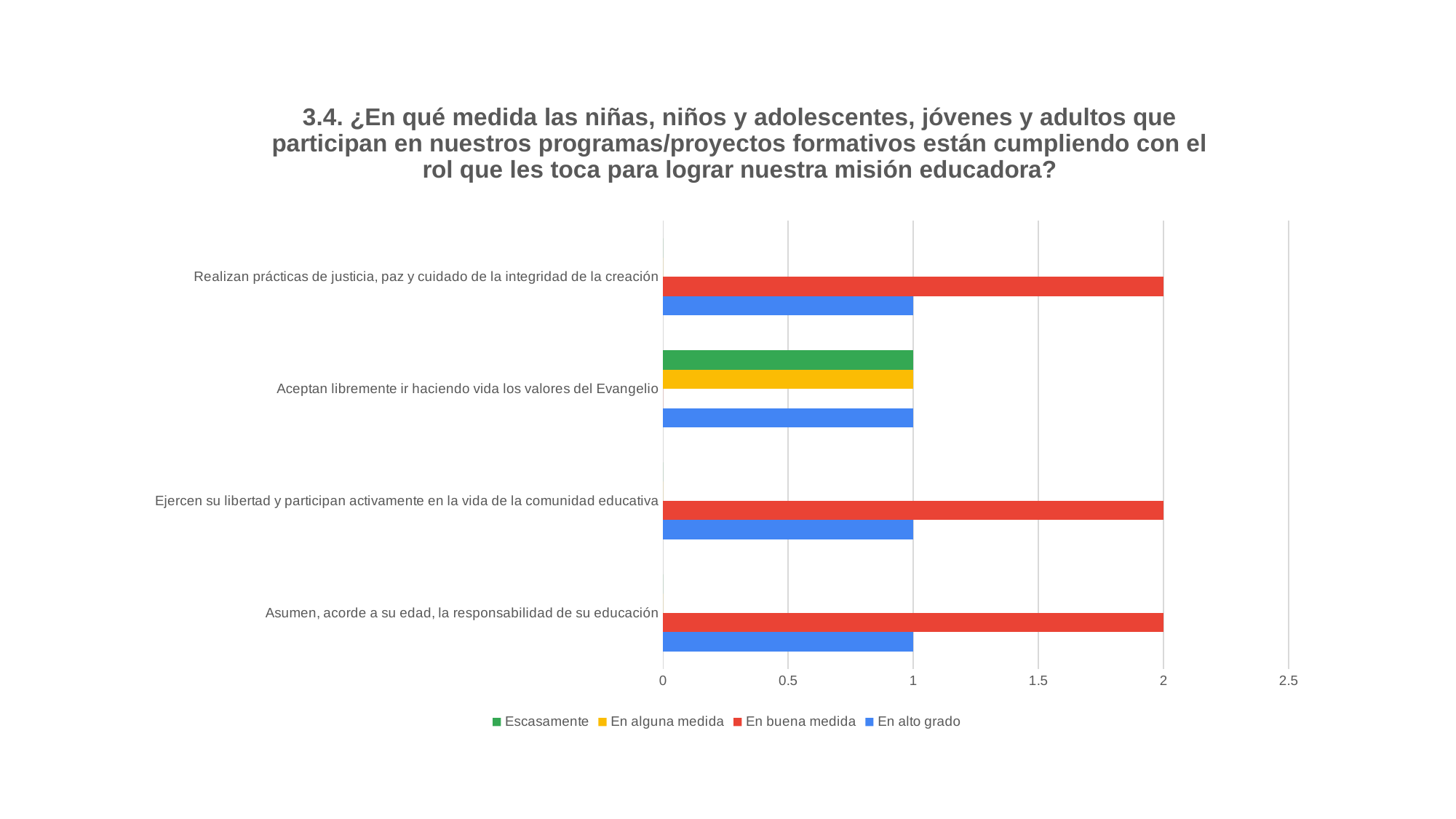
How many series does the legend list? 4 What is the value of "En buena medida" for "Ejercen su libertad y participan activamente en la vida de la comunidad educativa"? 2 What kind of chart is shown on the slide? bar chart What is the value of "Escasamente" for "Aceptan libremente ir haciendo vida los valores del Evangelio"? 1 What is the difference between "En buena medida" and "En alto grado" for "Asumen, acorde a su edad, la responsabilidad de su educación"? 1 How many categories are shown on the vertical axis of the chart? 4 Is the value of "En buena medida" for "Realizan prácticas de justicia, paz y cuidado de la integridad de la creación" greater or less than 1.5? greater For "Ejercen su libertad y participan activamente en la vida de la comunidad educativa", which is larger: "En buena medida" or "En alto grado"? En buena medida What is the value of "En buena medida" for "Realizan prácticas de justicia, paz y cuidado de la integridad de la creación"? 2 What is the value of "En alto grado" for "Asumen, acorde a su edad, la responsabilidad de su educación"? 1 Which category is the only one with a bar for "En alguna medida"? Aceptan libremente ir haciendo vida los valores del Evangelio What colour represents the "En alto grado" series in the legend? blue